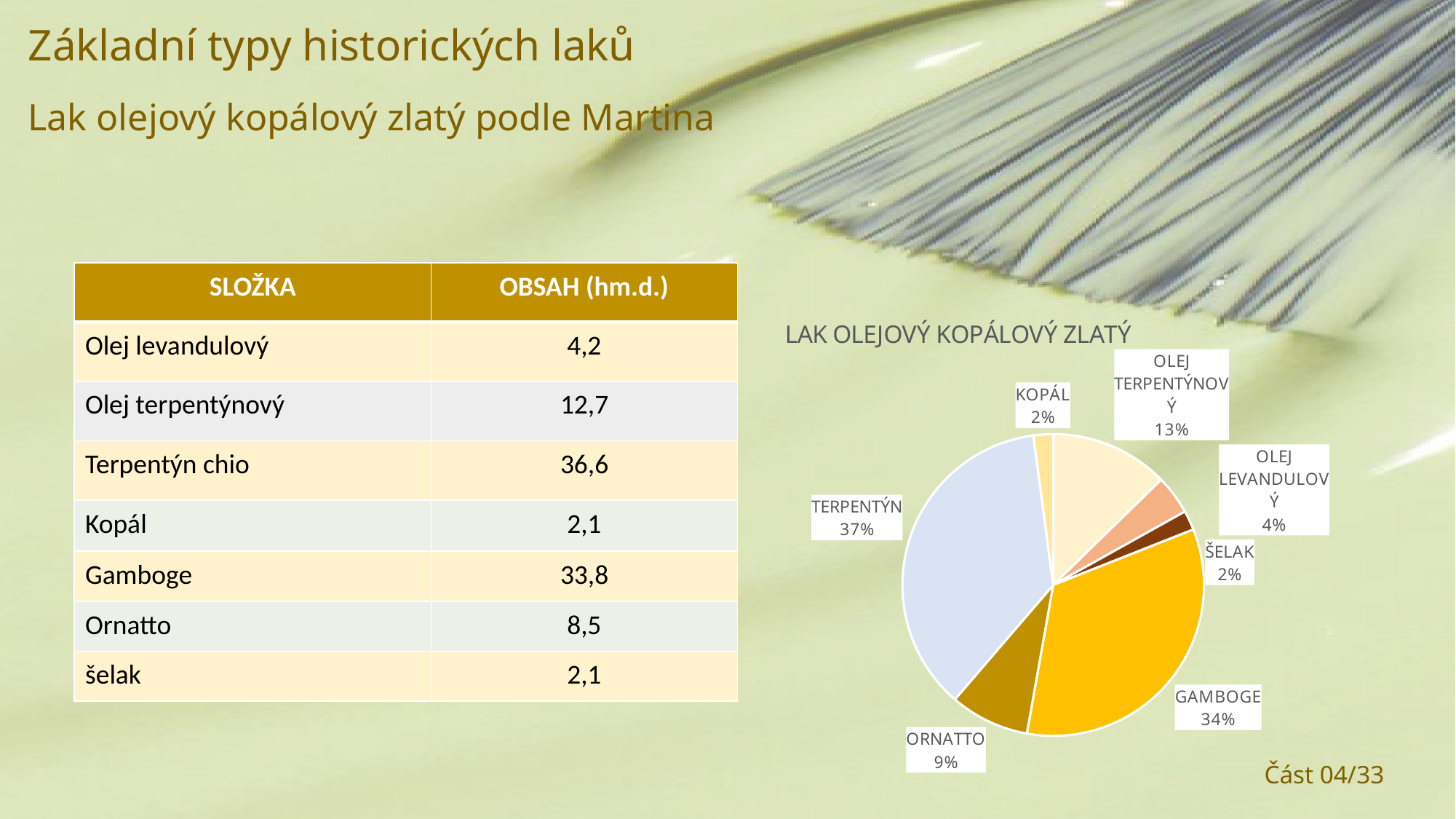
What is the title of the pie chart? LAK OLEJOVÝ KOPÁLOVÝ ZLATÝ How many slices does the pie chart have? 7 What share of the pie chart does TERPENTÝN represent? 37% What percentage is shown for KOPÁL in the pie chart? 2% Which slice of the pie chart is the largest? TERPENTÝN What percentage is shown for OLEJ LEVANDULOVÝ in the pie chart? 4% Which has a larger share in the pie chart, GAMBOGE or ORNATTO? GAMBOGE What share of the pie chart does GAMBOGE represent? 34% What is the difference in percentage points between TERPENTÝN and GAMBOGE in the pie chart? 3% What percentage is shown for ORNATTO in the pie chart? 9% What kind of chart is shown on the slide? pie chart What percentage is shown for OLEJ TERPENTÝNOVÝ in the pie chart? 13%